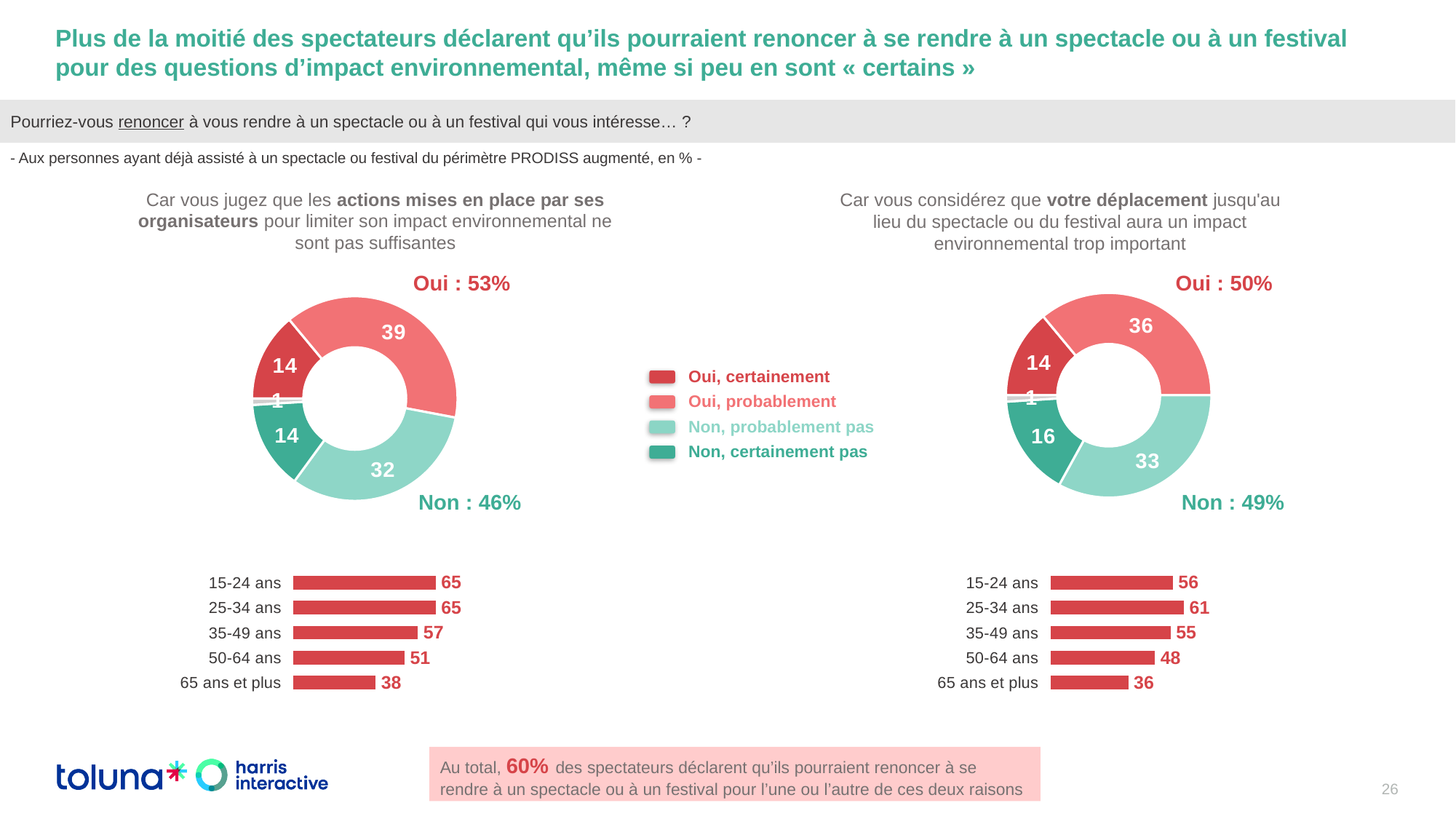
What is the total "Non" share shown next to the right donut chart? 49% In the bottom-right bar chart (by age, spectator's travel), which is larger: the value for "35-49 ans" or for "50-64 ans"? 35-49 ans In the bottom-right bar chart (by age, spectator's travel), which age group has the highest value? 25-34 ans In the right donut chart (about the spectator's travel), what is the value for "Non, certainement pas"? 16 In the left donut chart (about the organisers' actions), what is the value for "Oui, probablement"? 39 In the right donut chart (about the spectator's travel), what is the value for "Non, probablement pas"? 33 How many entries does the legend between the two donut charts list? 4 What kind of chart is used to show the results by age group at the bottom of the slide? Bar chart What is the total "Oui" share shown next to the left donut chart? 53% In the bottom-right bar chart (by age, spectator's travel), which age group has the lowest value? 65 ans et plus In the bottom-left bar chart (by age, organisers' actions), what is the value for "65 ans et plus"? 38 In the bottom-left bar chart (by age, organisers' actions), what is the difference between the values for "15-24 ans" and "50-64 ans"? 14